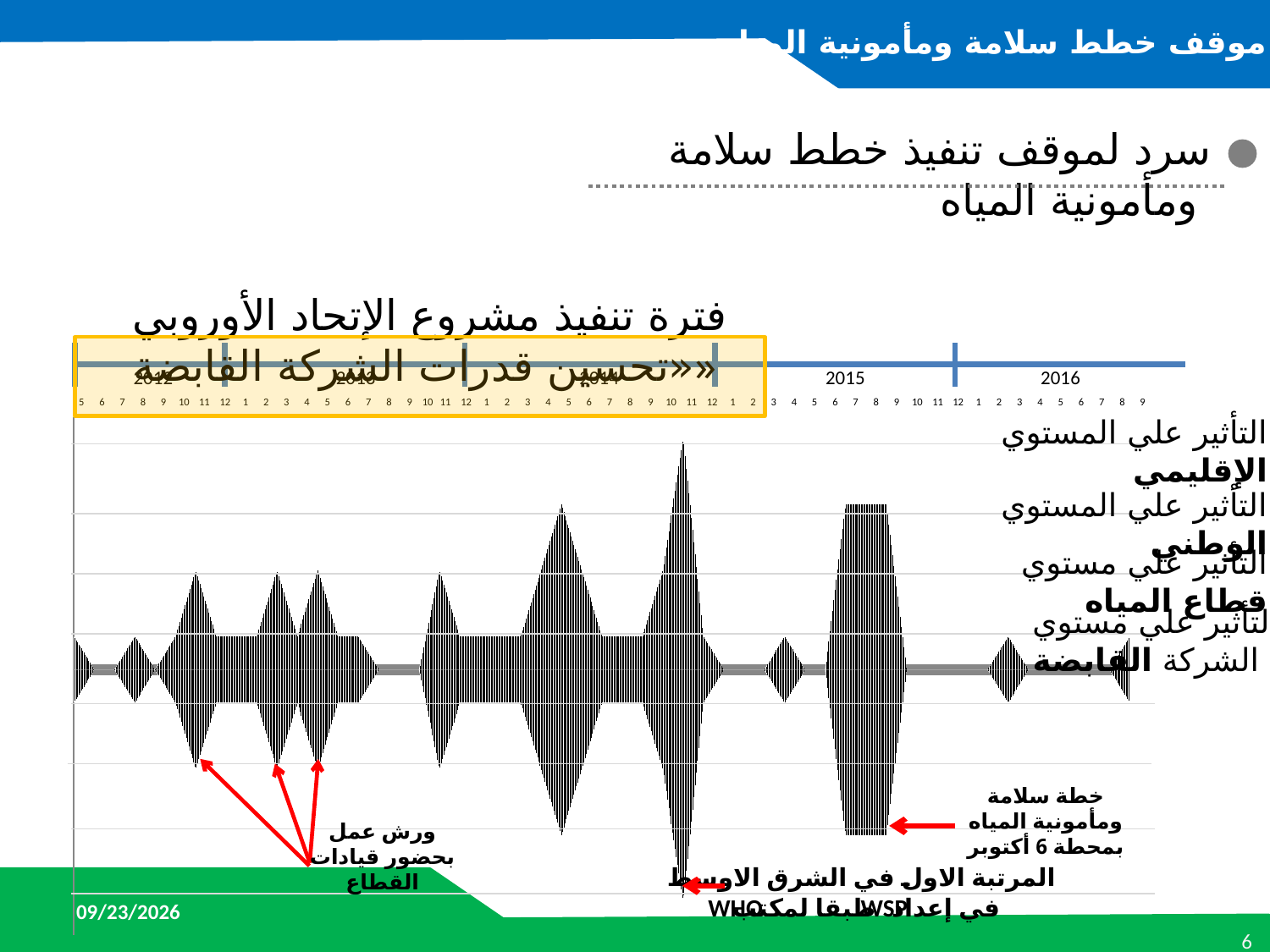
What is the first month number shown at the left end of the chart's x axis? 5 What is the last year shown on the chart's timeline axis? 2016 In which year does the tallest peak of the chart occur? 2014 What is the first year shown on the chart's timeline axis? 2012 What is the last month number shown at the right end of the chart's x axis? 9 What does the annotation with three red arrows pointing to the early peaks of the chart say? ورش عمل بحضور قيادات القطاع Which station is named in the annotation about the water safety plan (خطة سلامة ومأمونية المياه) on the chart? محطة 6 أكتوبر How many impact levels are listed as labels on the right side of the chart? 4 How many years are labelled along the chart's timeline axis? 5